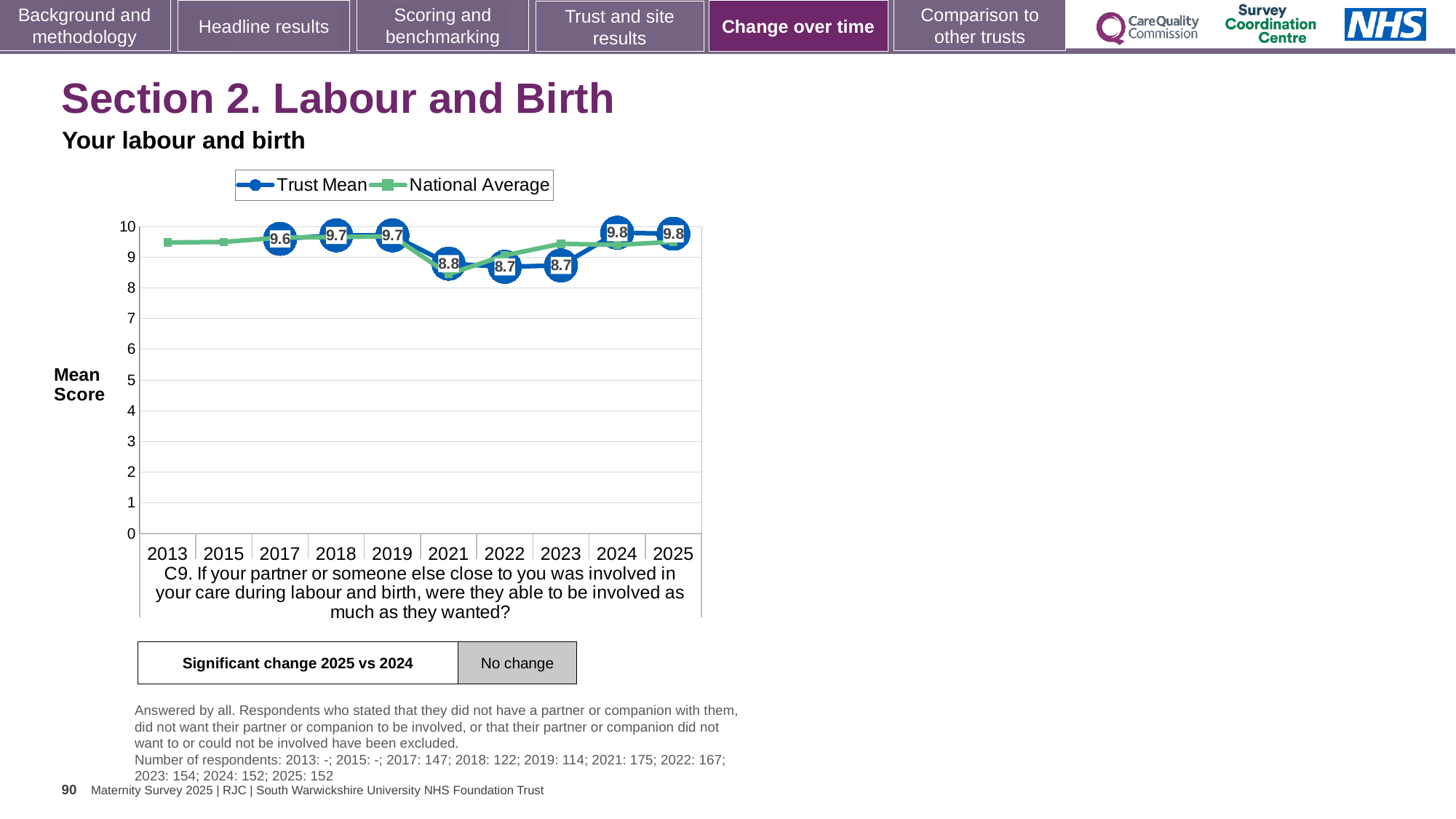
How many series does the chart legend list? 2 Which year has the larger Trust Mean value, 2018 or 2022? 2018 What is the Trust Mean value for 2021? 8.8 How many years are shown on the x axis of the chart? 10 What kind of chart is shown on the slide? line chart What is the label on the y axis of the chart? Mean Score What is the difference between the Trust Mean values for 2019 and 2021? 0.9 What is the Trust Mean value for 2023? 8.7 What is the Trust Mean value for 2017? 9.6 Does the Trust Mean rise or fall from 2023 to 2024? rise Is the National Average value for 2013 greater or less than 9? greater What is the Trust Mean value for 2025? 9.8